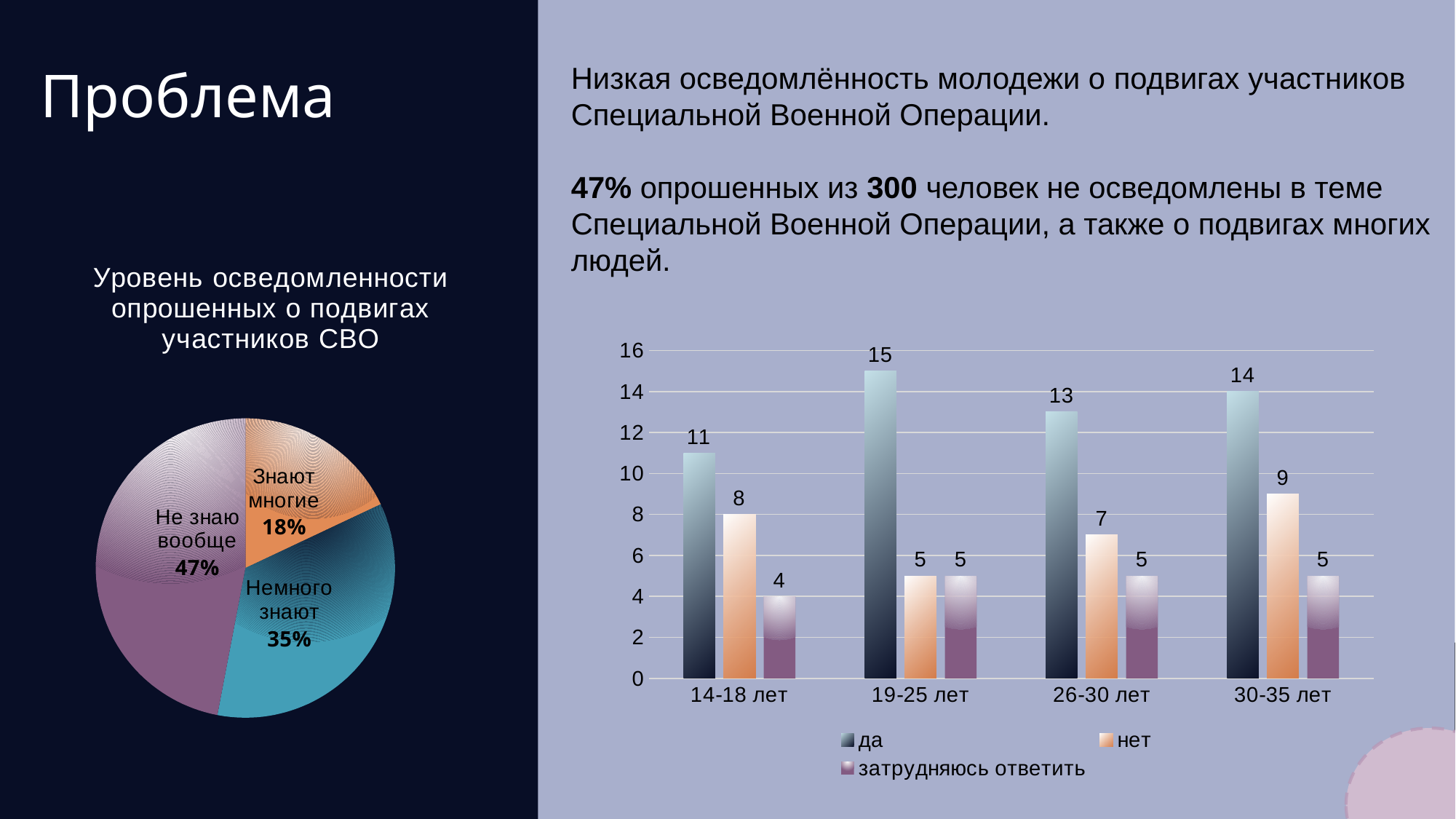
In the bar chart on the right, which age group has the highest value for "да"? 19-25 лет What type of chart is shown on the right side of the slide? Bar chart In the pie chart on the left, what share is labelled "Знают многие"? 18% In the pie chart on the left, which slice is the smallest? Знают многие In the pie chart on the left, how many slices are there? 3 In the bar chart on the right, what is the value of "нет" for 30-35 лет? 9 In the bar chart on the right, what is the value of "да" for 19-25 лет? 15 In the pie chart on the left, which slice is the largest? Не знаю вообще In the bar chart on the right, how many series does the legend list? 3 In the pie chart on the left, what share is labelled "Не знаю вообще"? 47% In the bar chart on the right, what is the value of "затрудняюсь ответить" for 14-18 лет? 4 In the bar chart on the right, what is the difference between "да" and "нет" for 26-30 лет? 6